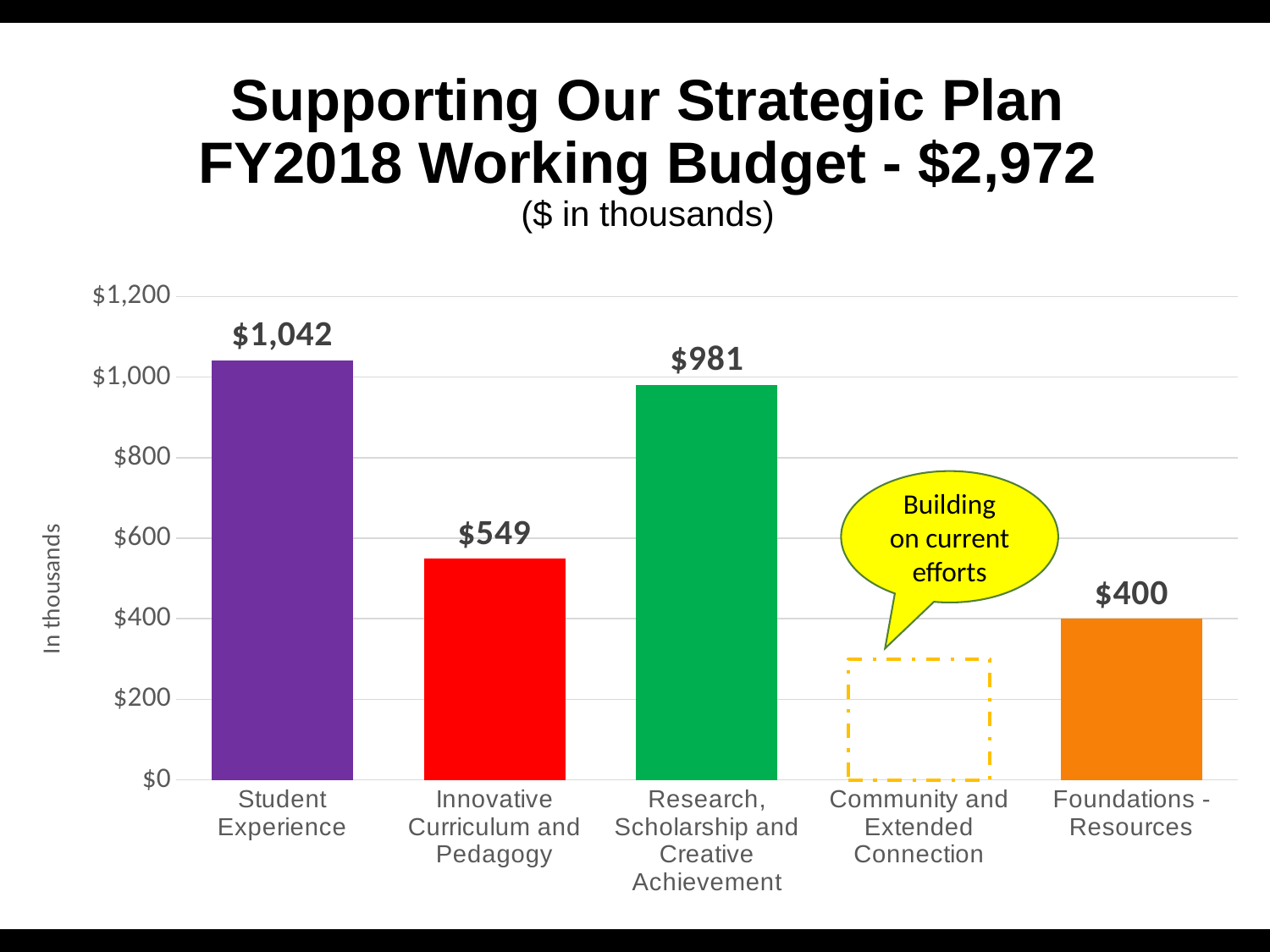
What is the value for Student Experience? $1,042 Among the categories with a printed value, which has the lowest value? Foundations - Resources What kind of chart is shown on the slide? Bar chart What is the value for Research, Scholarship and Creative Achievement? $981 What is the difference between the values for Innovative Curriculum and Pedagogy and Foundations - Resources? $149 What is the difference between the values for Student Experience and Research, Scholarship and Creative Achievement? $61 What text appears in the callout above the Community and Extended Connection category? Building on current efforts What is the value for Foundations - Resources? $400 Which is larger, the value for Innovative Curriculum and Pedagogy or the value for Research, Scholarship and Creative Achievement? Research, Scholarship and Creative Achievement Which category has the highest value? Student Experience How many categories are shown on the x axis? 5 What is the value for Innovative Curriculum and Pedagogy? $549